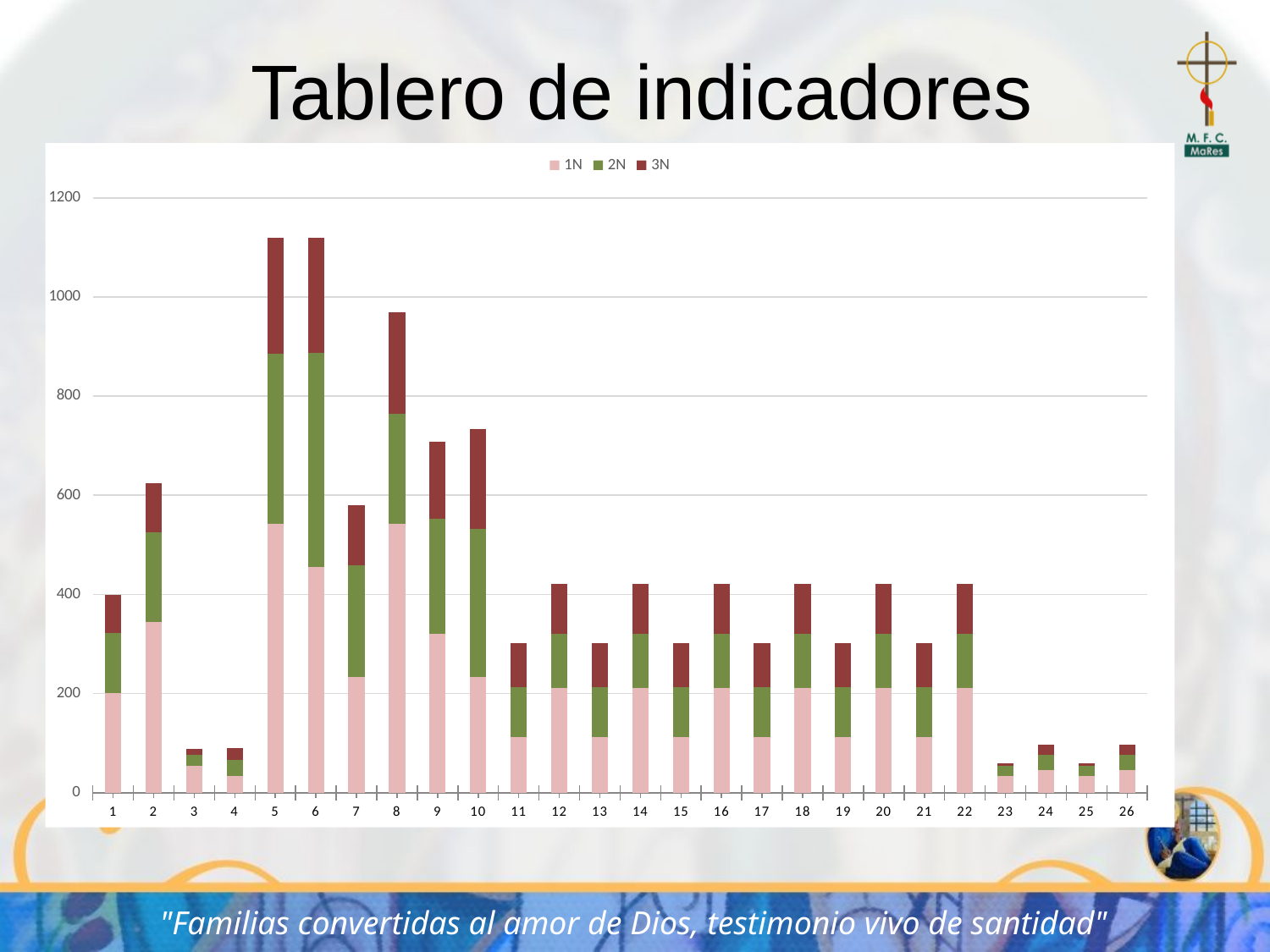
What is the title of the slide containing the chart? Tablero de indicadores How many categories are shown along the x axis? 26 Which bar is taller, category 10 or category 12? Category 10 What are the names of the series listed in the legend? 1N, 2N, 3N How many series does the legend list? 3 Is the total value of the bar for category 5 greater or less than 1000? greater Is the total value of the bar for category 23 greater or less than 100? less Is the total value of the bar for category 2 greater or less than 600? greater What kind of chart is shown on the slide? Stacked bar chart Which bar is taller, category 8 or category 9? Category 8